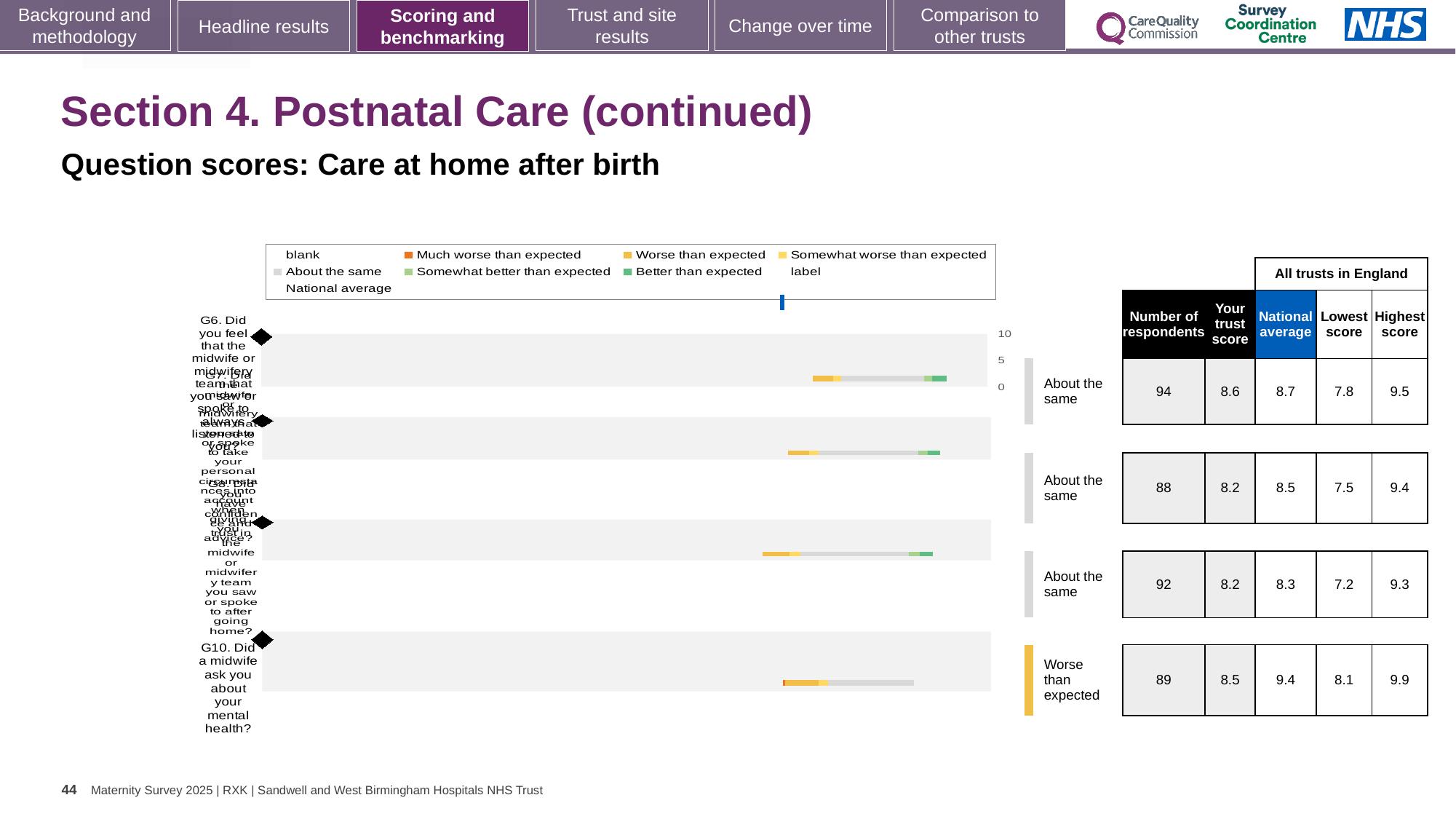
What benchmark category is given for the G10 mental health question? Worse than expected What is the trust score for the first (top) question row, G6? 8.6 What is the trust score for the bottom row, G10 'Did a midwife ask you about your mental health?' 8.5 Which question row has the highest number of respondents? G6 (top row), 94 What is the national average for the G10 mental health question? 9.4 What is the difference between the national average and the trust score for the G10 mental health question? 0.9 How many respondents answered the G10 mental health question? 89 What is the highest score across all trusts in England for the G10 mental health question? 9.9 What kind of chart is shown on the slide? bar chart How many question rows (bars) are plotted in the chart? 4 Which is larger for the top row (G6): the trust score or the national average? national average (8.7) What is the lowest score across all trusts in England for the third question row? 7.2